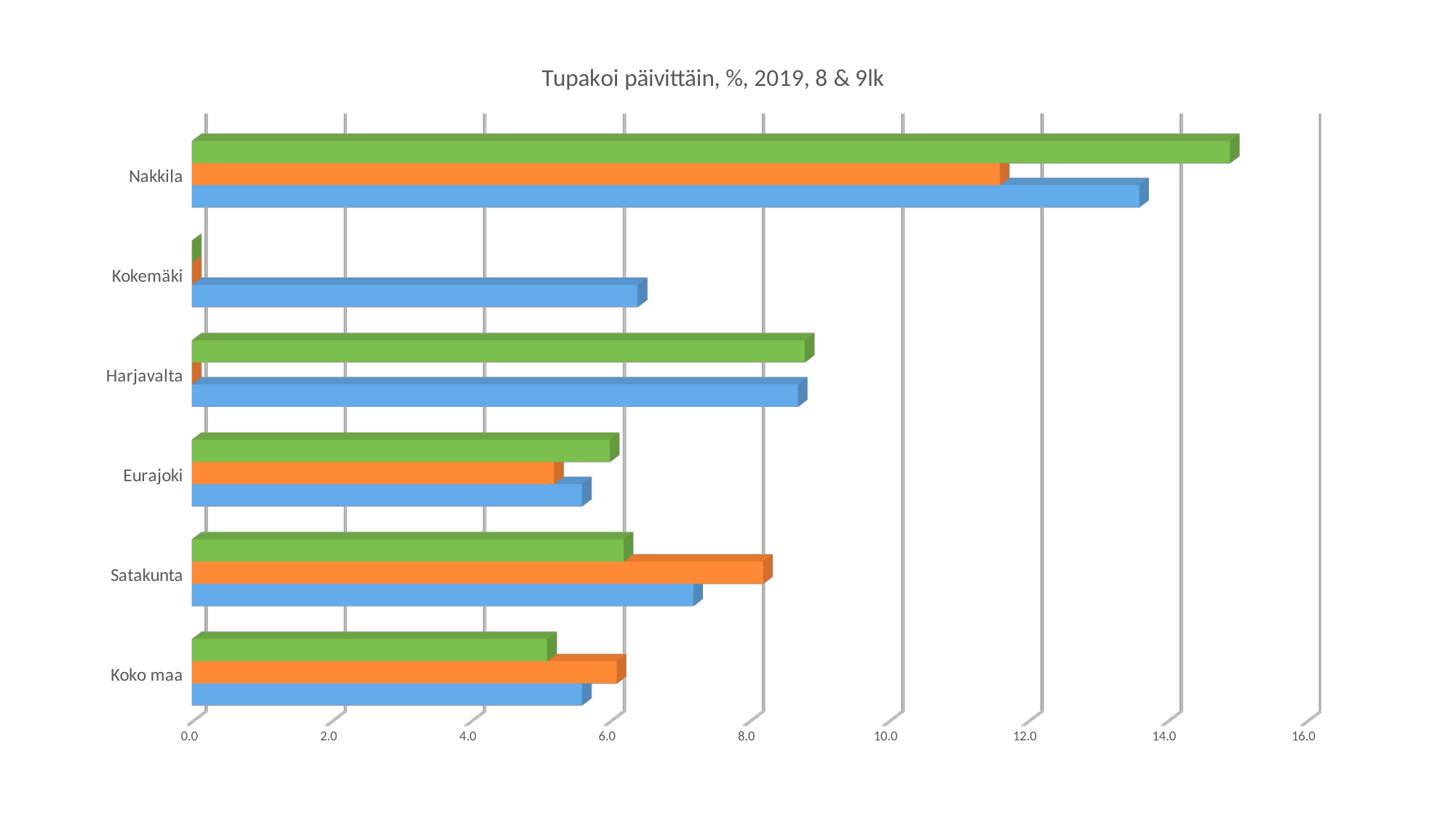
Is the green bar for Harjavalta greater or less than 8.0? greater Which category has the longest blue bar? Nakkila What is the title of the chart? Tupakoi päivittäin, %, 2019, 8 & 9lk Is the blue bar for Satakunta greater or less than 8.0? less How many categories are listed on the vertical axis of the chart? 6 What kind of chart is shown on the slide? bar chart How many bars are plotted for each category in the chart? 3 Is the blue bar for Nakkila greater or less than 12.0? greater For Satakunta, which is larger, the orange bar or the blue bar? the orange bar Which category has the longest green bar? Nakkila